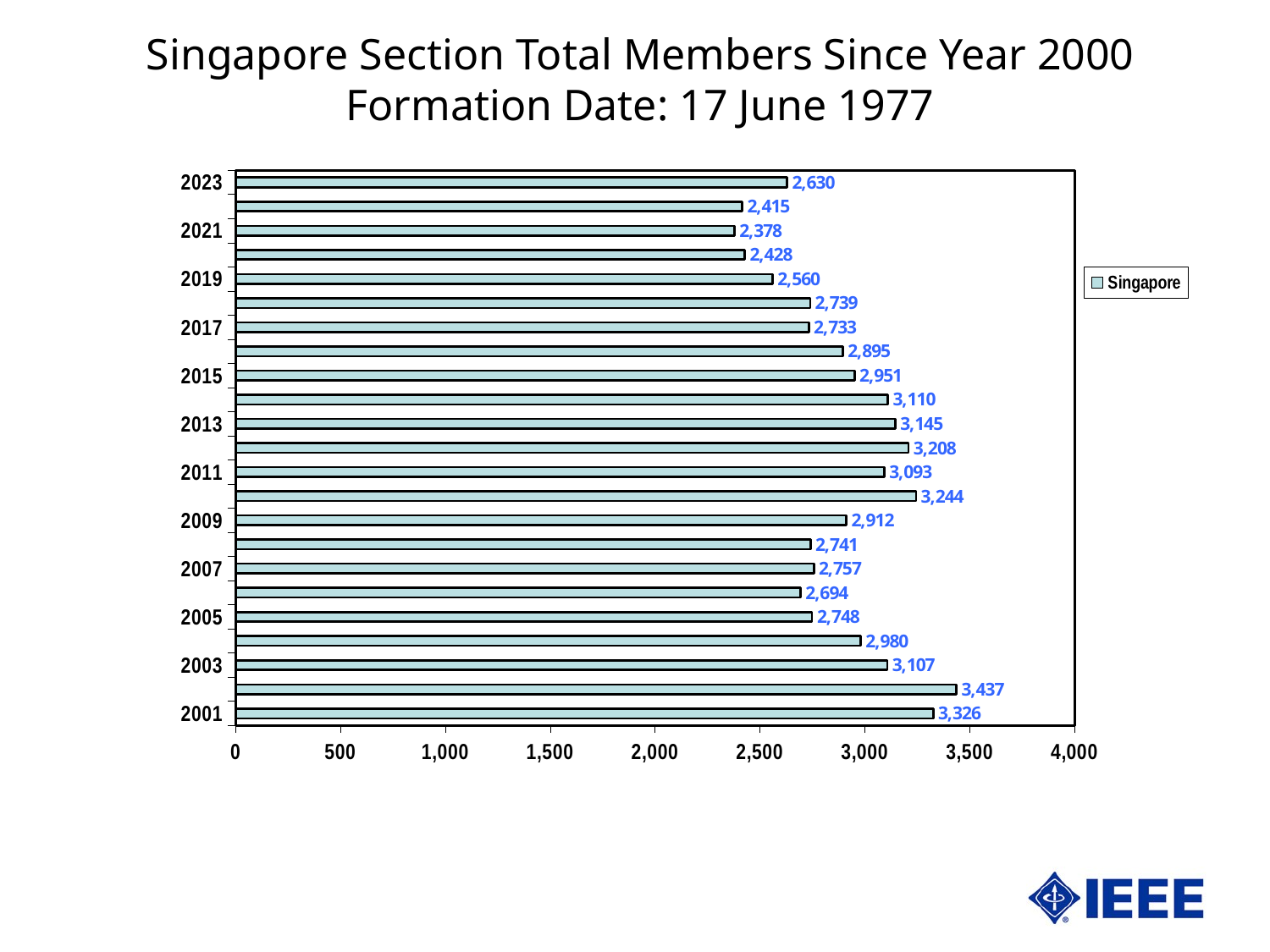
How many series does the legend list? 1 What kind of chart is shown? bar chart What is the value for 2019? 2,560 What is the difference between the values for 2001 and 2023? 696 What is the highest value shown on the chart? 3,437 What is the value for 2023? 2,630 How many bars are plotted on the chart? 23 What is the value for 2013? 3,145 Which is larger, the value for 2009 or the value for 2019? 2009 Which labelled year has the lowest value? 2021 What is the value for 2001? 3,326 Is the value for 2015 greater or less than 2,500? greater